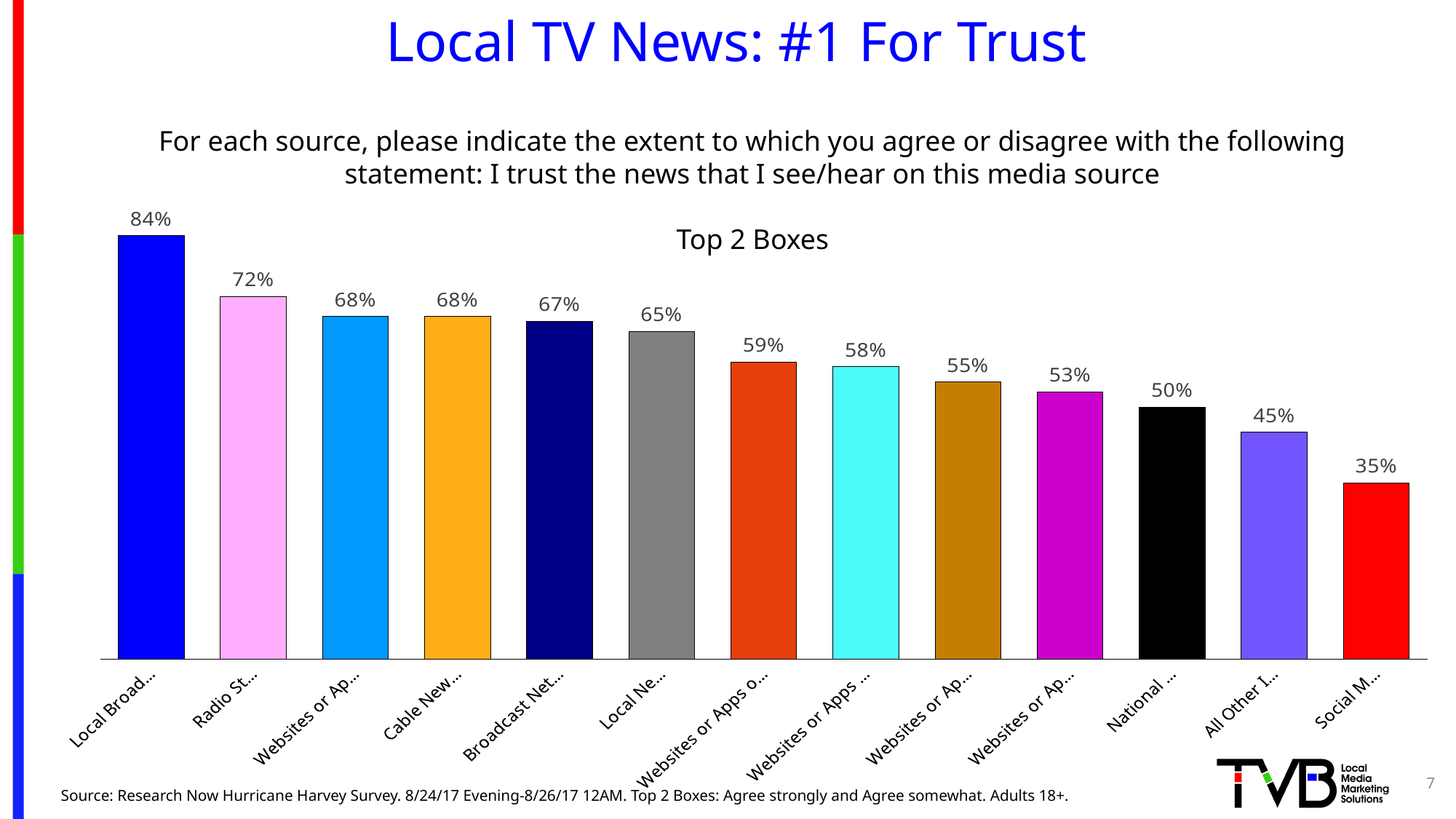
What is the value shown for the bar labelled "National ..."? 50% What is the value shown for the bar labelled "All Other I..."? 45% How many bars (media sources) are plotted in the chart? 13 Which media source has the highest trust value in the chart? Local Broad... (the first bar), 84% What is the title printed above the bars in the chart? Top 2 Boxes What is the value shown for the bar labelled "Radio St..."? 72% Which has the larger value: the bar labelled "Radio St..." or the bar labelled "Broadcast Net..."? Radio St... What is the difference in percentage points between the first bar (Local Broad..., 84%) and the last bar (Social M..., 35%)? 49 percentage points Which media source has the lowest trust value in the chart? Social M... (the last bar), 35% What kind of chart is shown on the slide? Bar chart Do the bar values rise or fall from left to right across the chart? Fall What is the value shown for the bar labelled "Cable New..."? 68%